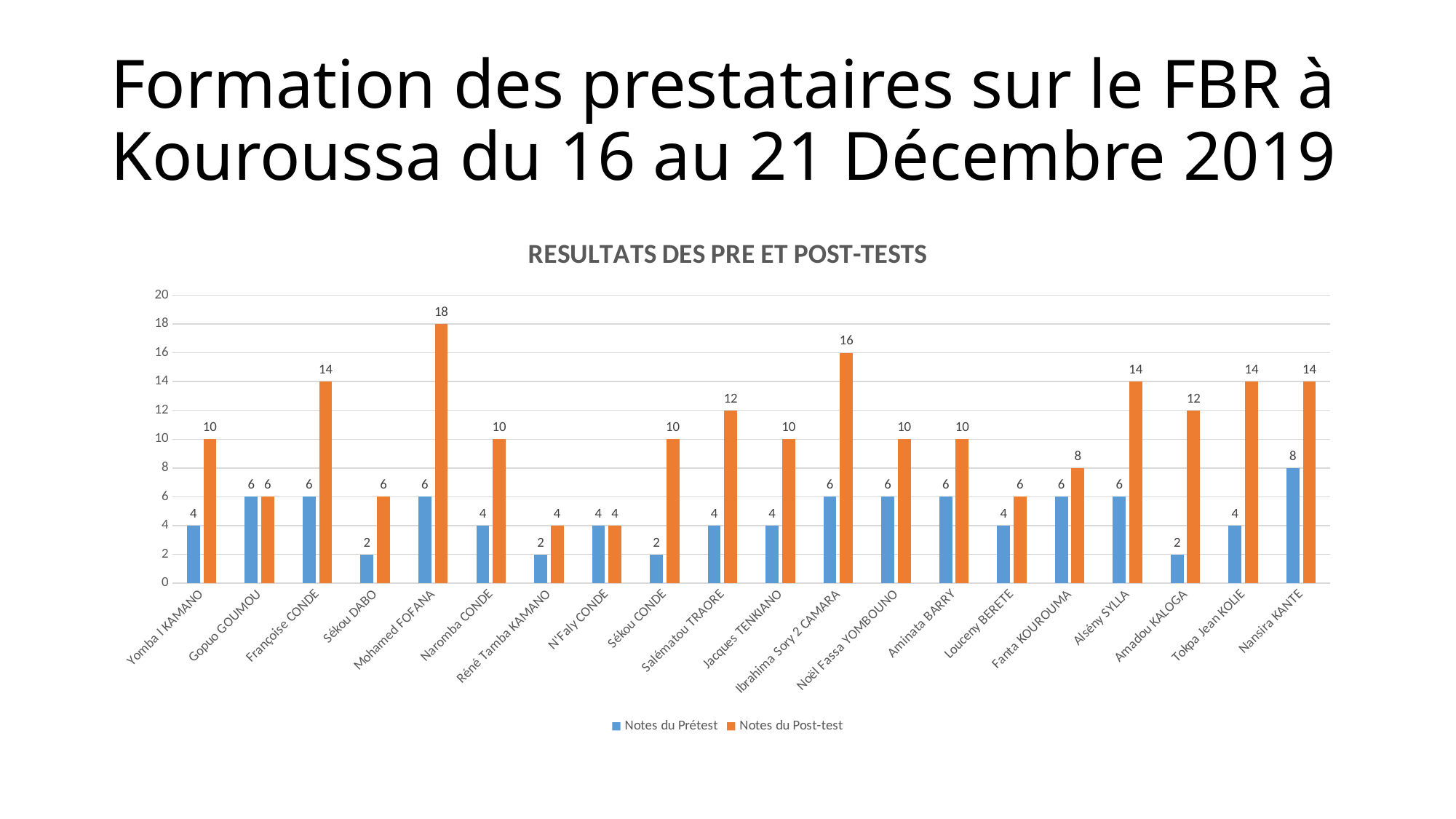
What is the pretest score (Notes du Prétest) for Nansira KANTE? 8 What kind of chart is shown on the slide? Bar chart What is the post-test score for Ibrahima Sory 2 CAMARA? 16 How many participants are shown on the x axis of the chart? 20 Which participant has the highest pretest score? Nansira KANTE What is the difference between the post-test and pretest scores for Mohamed FOFANA? 12 Which is larger for Amadou KALOGA: the pretest score or the post-test score? Post-test score What is the title of the chart? RESULTATS DES PRE ET POST-TESTS What is the post-test score (Notes du Post-test) for Mohamed FOFANA? 18 Which colour represents the Notes du Post-test series? Orange How many series does the legend list? 2 Which participant has the highest post-test score? Mohamed FOFANA